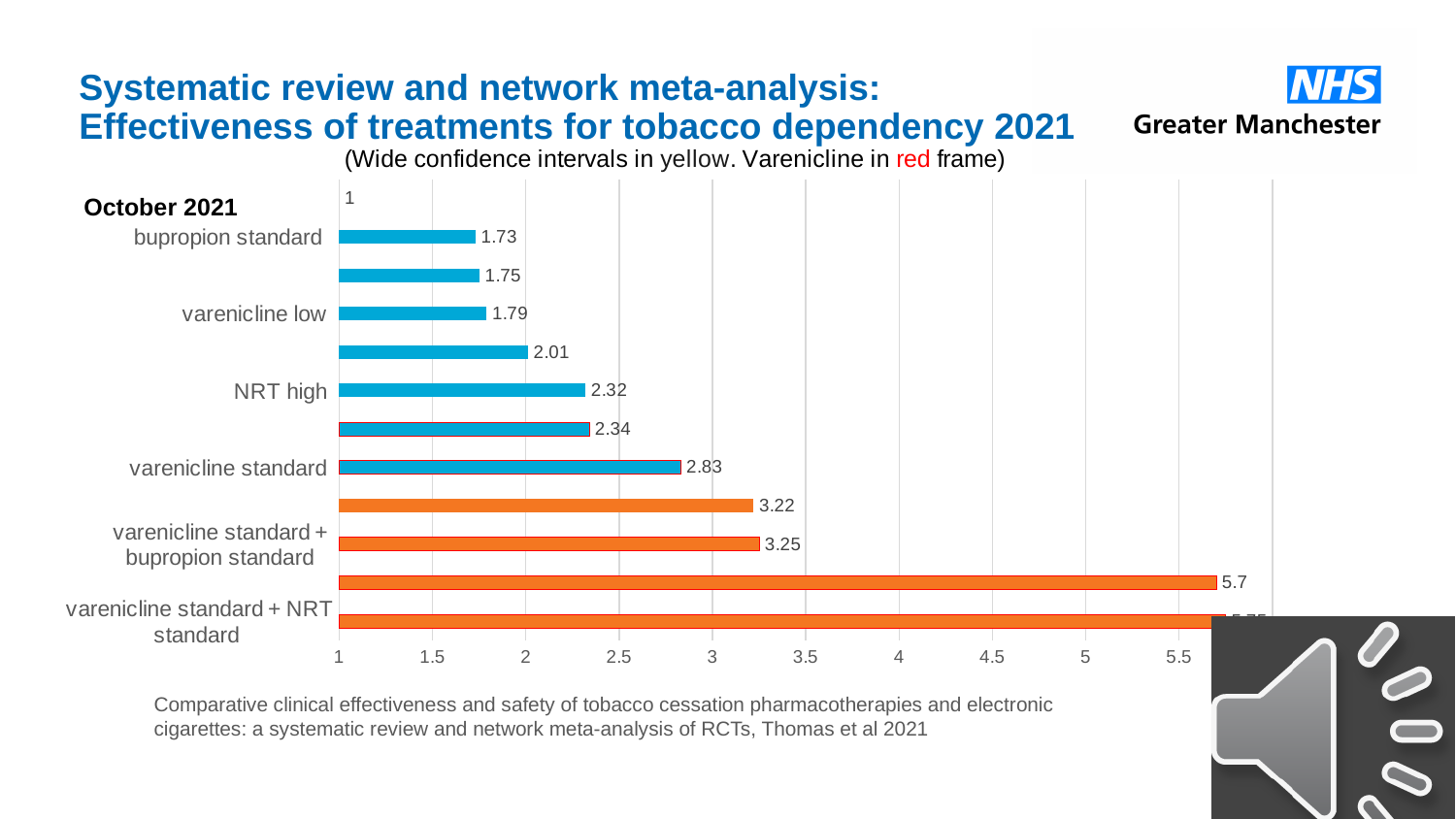
What kind of chart is shown on the slide? bar chart What is the difference between the values for NRT high and varenicline low? 0.53 What is the value shown for bupropion standard? 1.73 Which treatment's bar is outlined with a red frame? varenicline standard What is the value shown for varenicline standard + bupropion standard? 3.25 What is the value shown for NRT high? 2.32 What is the value shown for varenicline standard? 2.83 What is the difference between the values for varenicline standard and bupropion standard? 1.1 Among the labelled treatments, which has the highest value? varenicline standard + NRT standard What is the value shown for varenicline low? 1.79 Which has the larger value, varenicline standard or NRT high? varenicline standard Is the value for varenicline standard + NRT standard greater or less than 5.5? greater